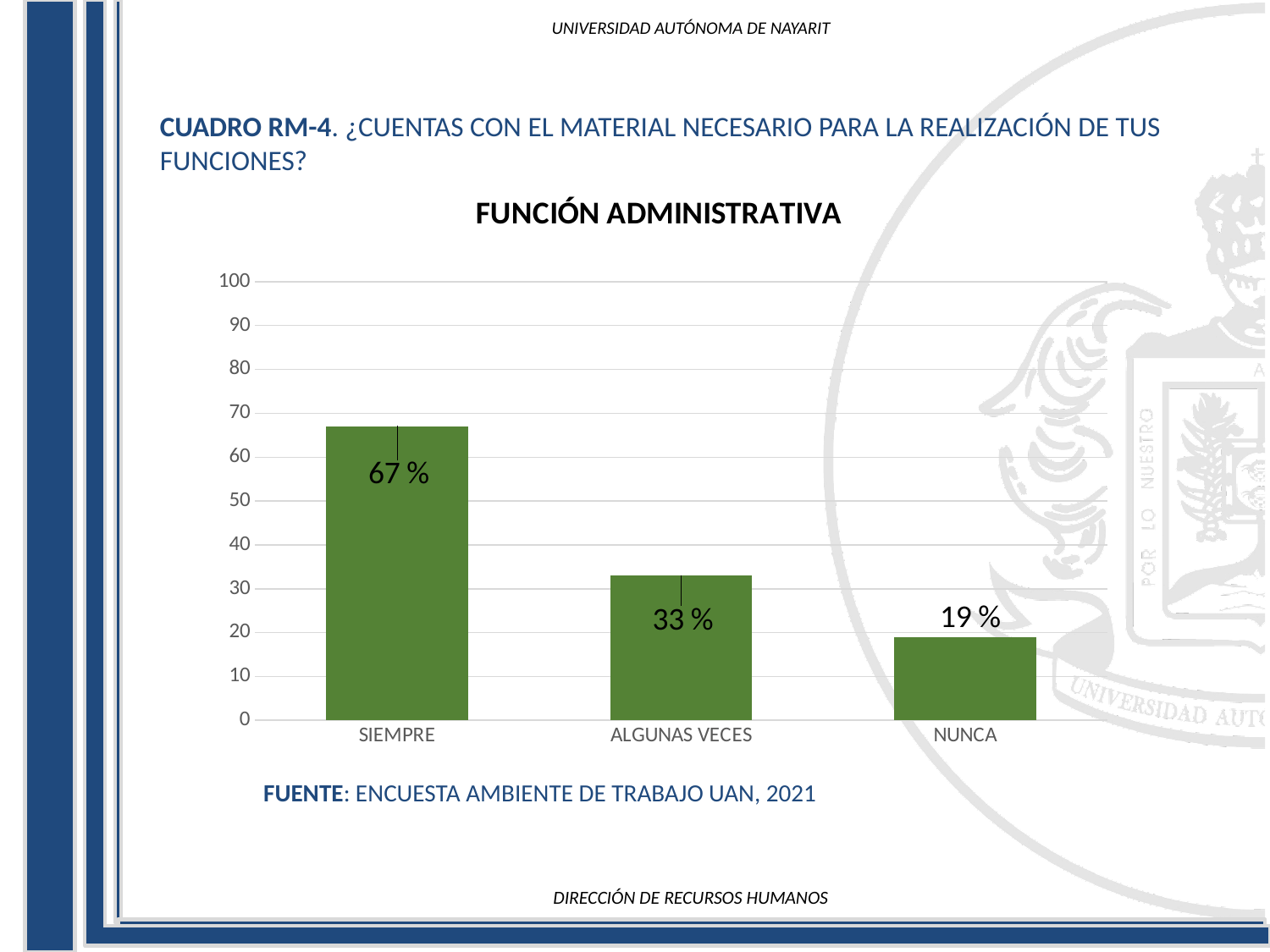
What is the value for ALGUNAS VECES? 33 % What is the value for NUNCA? 19 % How many categories are shown on the x axis? 3 What kind of chart is shown on the slide? bar chart What is the difference between the values for SIEMPRE and ALGUNAS VECES? 34 % Which is larger, the value for ALGUNAS VECES or the value for NUNCA? ALGUNAS VECES Which category has the lowest value? NUNCA What is the value for SIEMPRE? 67 % Is the value for SIEMPRE greater or less than 60? greater What is the title of the chart? FUNCIÓN ADMINISTRATIVA Which category has the highest value? SIEMPRE What is the difference between the values for ALGUNAS VECES and NUNCA? 14 %